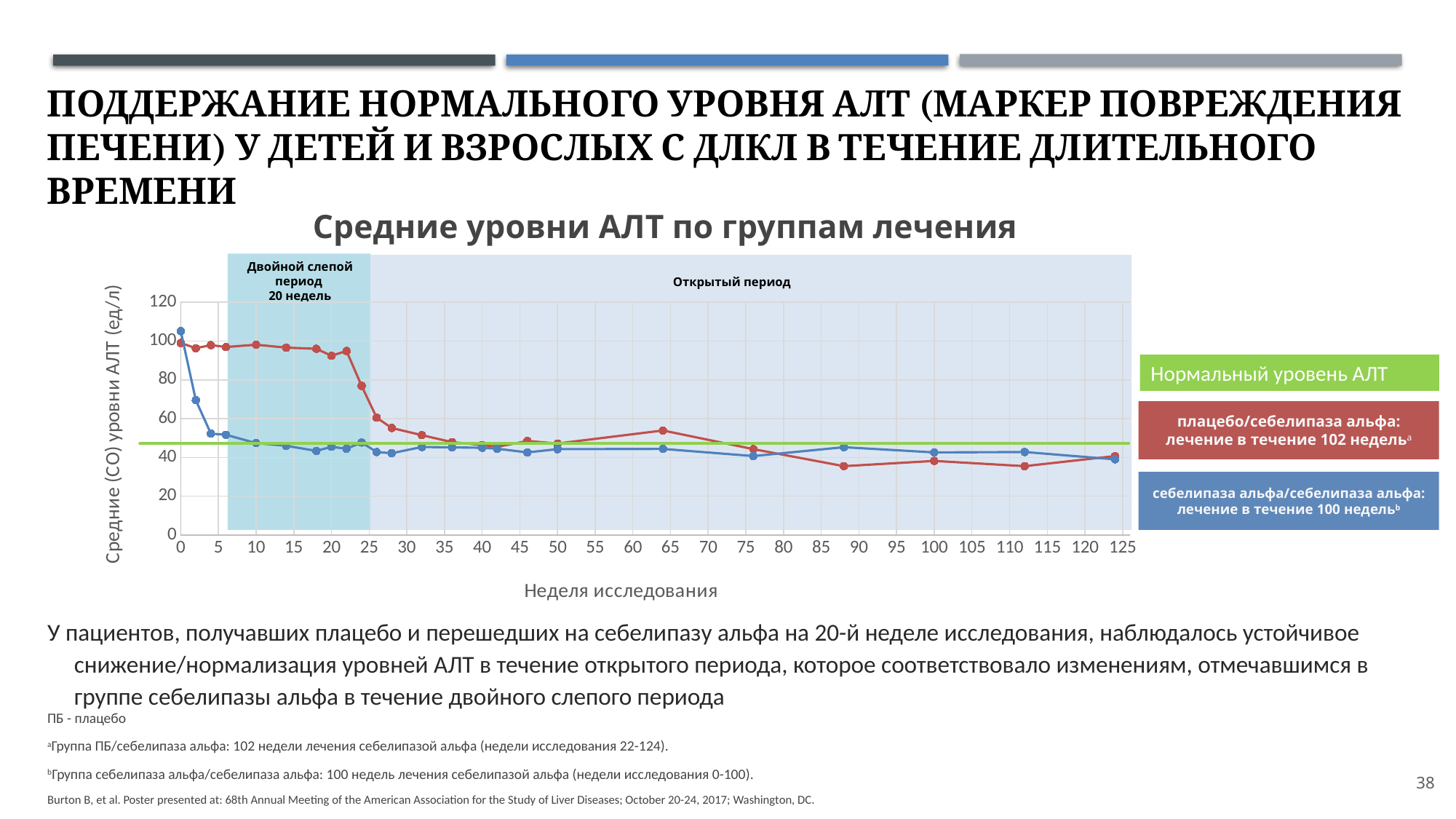
What is the title of the chart? Средние уровни АЛТ по группам лечения What kind of chart is shown on the slide? Line chart Is the value for the себелипаза альфа/себелипаза альфа series at week 10 greater or less than 60? less Is the value for the плацебо/себелипаза альфа series at week 88 greater or less than 40? less At week 0, which series has the larger value: плацебо/себелипаза альфа or себелипаза альфа/себелипаза альфа? себелипаза альфа/себелипаза альфа Is the value for the плацебо/себелипаза альфа series at week 22 greater or less than 80? greater At week 10, which series has the larger value: плацебо/себелипаза альфа or себелипаза альфа/себелипаза альфа? плацебо/себелипаза альфа What is the label of the x axis? Неделя исследования What is the highest tick value shown on the y axis? 120 How many entries does the chart's legend list? 3 Does the плацебо/себелипаза альфа series rise or fall overall from week 0 to week 124? Fall